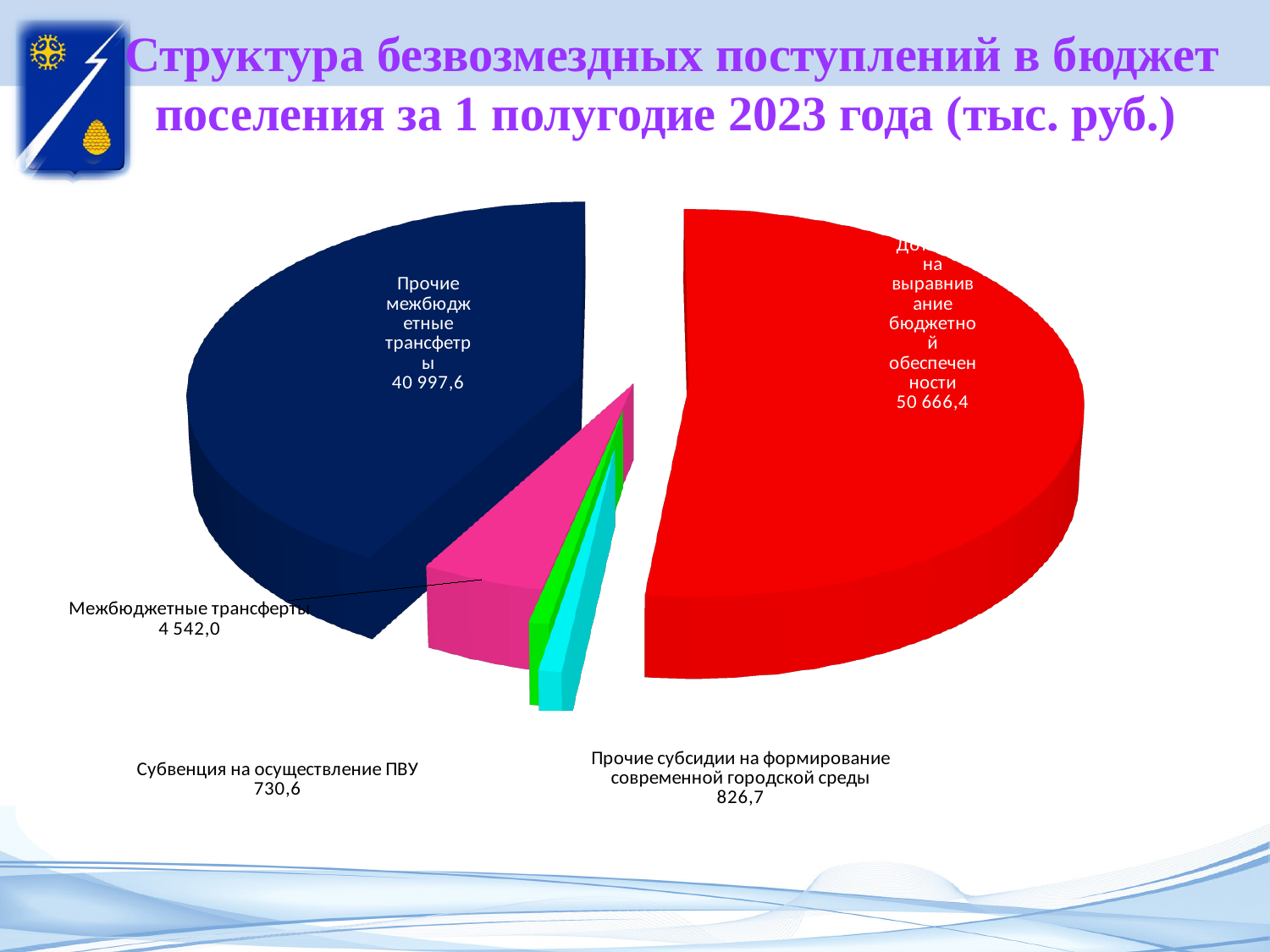
What is the value for Прочие субсидии на формирование современной городской среды? 826,7 How many slices does the pie chart have? 5 What is the value of the red slice (дотации на выравнивание бюджетной обеспеченности)? 50 666,4 What is the value for Межбюджетные трансферты? 4 542,0 Which is larger: Прочие субсидии на формирование современной городской среды or Субвенция на осуществление ПВУ? Прочие субсидии на формирование современной городской среды What is the value for Прочие межбюджетные трансферты? 40 997,6 Which category has the smallest value? Субвенция на осуществление ПВУ What colour is the slice for Прочие межбюджетные трансферты? Dark blue What is the value for Субвенция на осуществление ПВУ? 730,6 Which category has the largest value? Дотации на выравнивание бюджетной обеспеченности What kind of chart is shown on the slide? Pie chart What is the difference between the red slice (50 666,4) and Прочие межбюджетные трансферты? 9 668,8